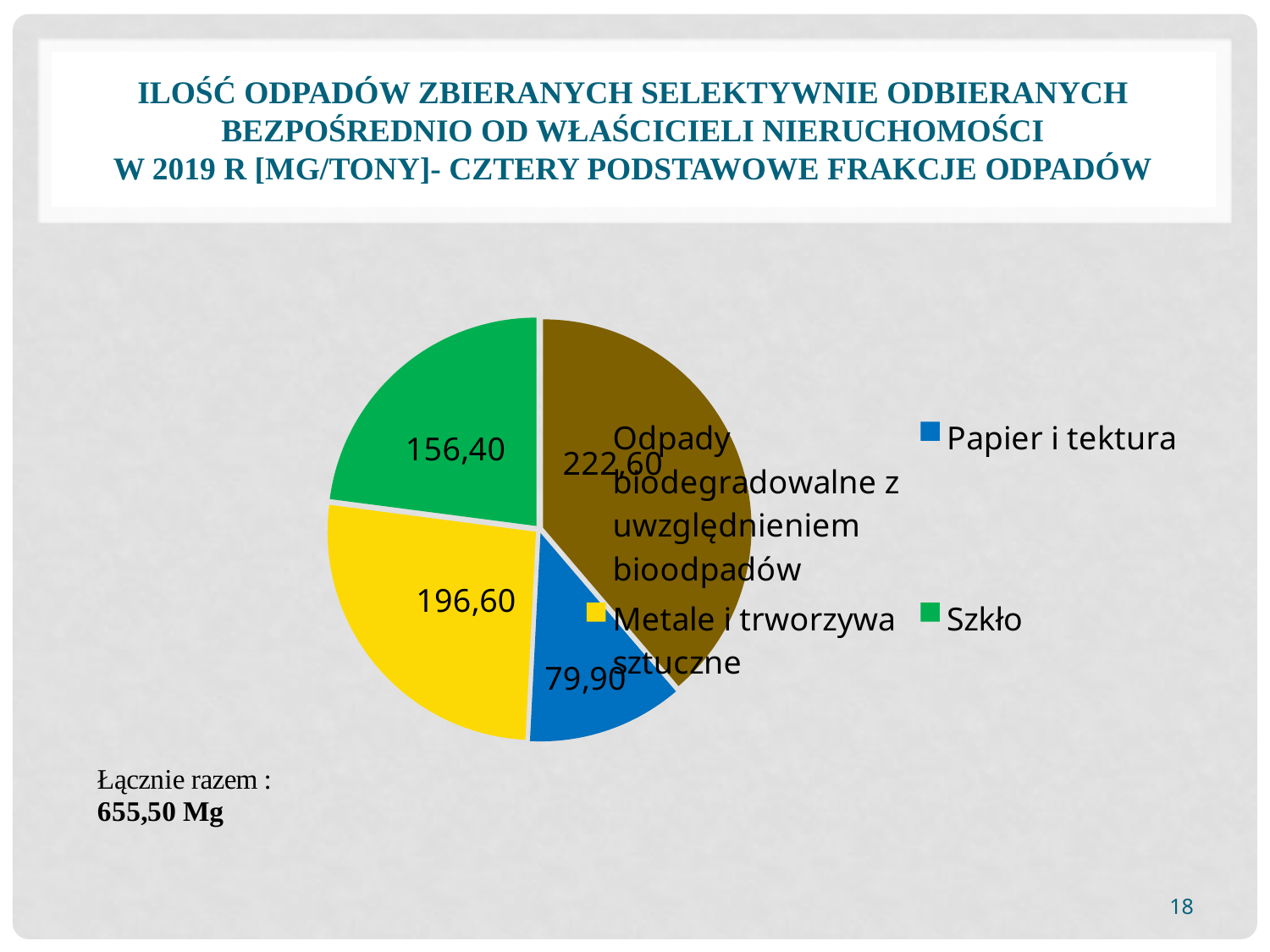
What is the value for Papier i tektura? 79,90 Which waste fraction has the smallest value? Papier i tektura Which waste fraction has the largest value? Odpady biodegradowalne z uwzględnieniem bioodpadów What type of chart is shown on the slide? pie chart What is the value for Szkło? 156,40 What is the value for Odpady biodegradowalne z uwzględnieniem bioodpadów? 222,60 What is the value for Metale i trworzywa sztuczne? 196,60 What is the total of all four fractions shown on the slide? 655,50 Mg Which is larger, Metale i trworzywa sztuczne or Szkło? Metale i trworzywa sztuczne How many slices does the pie chart have? 4 What colour is the slice for Szkło? green What is the difference between the values for Odpady biodegradowalne z uwzględnieniem bioodpadów and Papier i tektura? 142,70